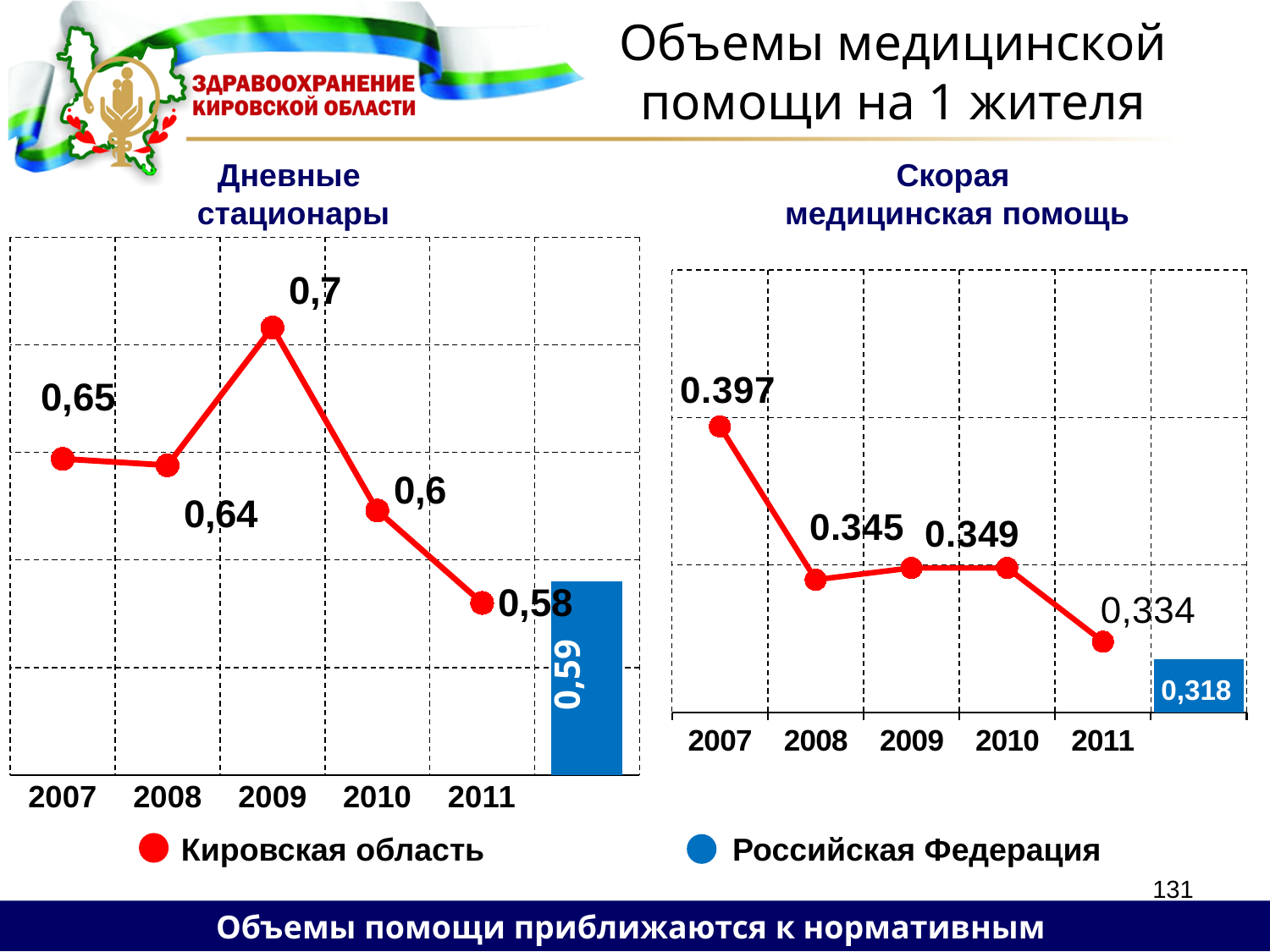
How many series does the legend at the bottom of the slide list? 2 On the 'Скорая медицинская помощь' chart, what is the value for Кировская область in 2011? 0,334 On the 'Дневные стационары' chart, which year has the lowest value for Кировская область? 2011 On the 'Дневные стационары' chart, what is the difference between the 2009 and 2010 values for Кировская область? 0,1 On the 'Дневные стационары' chart, what is the value shown for Российская Федерация? 0,59 On the 'Скорая медицинская помощь' chart, what is the value shown for Российская Федерация? 0,318 How many years are shown on the x axis of the 'Дневные стационары' chart? 5 On the 'Дневные стационары' chart, which year has the highest value for Кировская область? 2009 On the 'Скорая медицинская помощь' chart, what is the value for Кировская область in 2007? 0.397 On the 'Дневные стационары' chart, what is the value for Кировская область in 2011? 0,58 On the 'Дневные стационары' chart, what is the value for Кировская область in 2009? 0,7 On the 'Скорая медицинская помощь' chart, which is larger: the 2007 value or the 2008 value for Кировская область? 2007